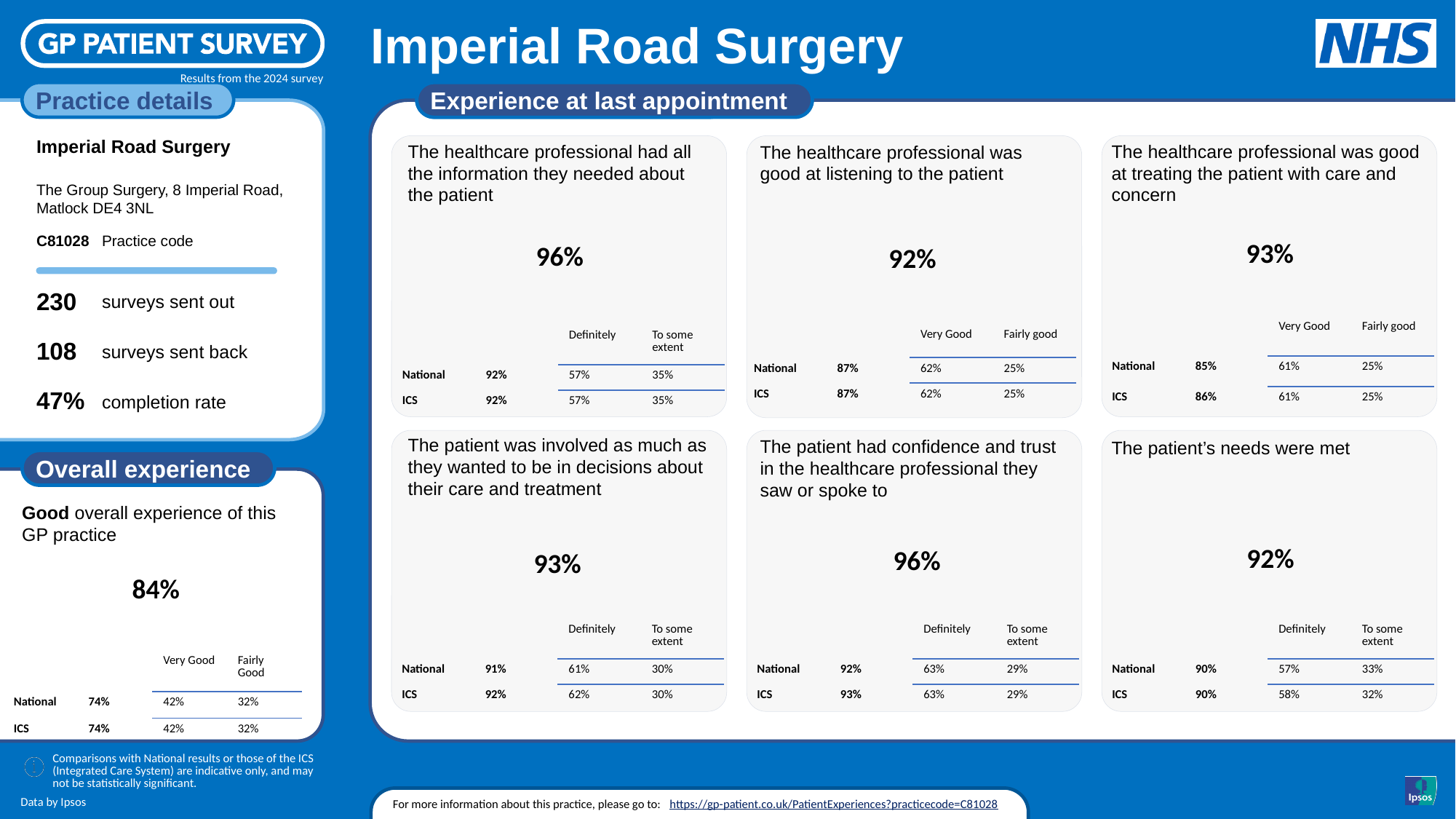
In the 'Overall experience' panel, what is the National value for good overall experience? 74% In the 'Overall experience' panel, what percentage of patients reported a good overall experience of this GP practice? 84% In the 'Overall experience' panel, what are the two response categories listed in the table header? Very Good and Fairly Good How many question panels are shown under 'Experience at last appointment'? 6 In the panel 'The patient had confidence and trust in the healthcare professional they saw or spoke to', what is the National 'Definitely' value? 63% Which is larger: the practice's 96% for 'The patient had confidence and trust in the healthcare professional' or the National 92% in the same panel? The practice's 96% In the panel 'The healthcare professional was good at listening to the patient', what is the ICS 'Very Good' value? 62% In the panel 'The patient was involved as much as they wanted to be in decisions about their care and treatment', what is the ICS value? 92% In the panel 'The healthcare professional had all the information they needed about the patient', what is the practice's percentage? 96% In the panel 'The patient's needs were met', what is the ICS 'To some extent' value? 32% In the 'Overall experience' panel, what is the difference between the practice's 84% and the National 74%? 10% In the panel 'The healthcare professional was good at treating the patient with care and concern', what is the National value? 85%